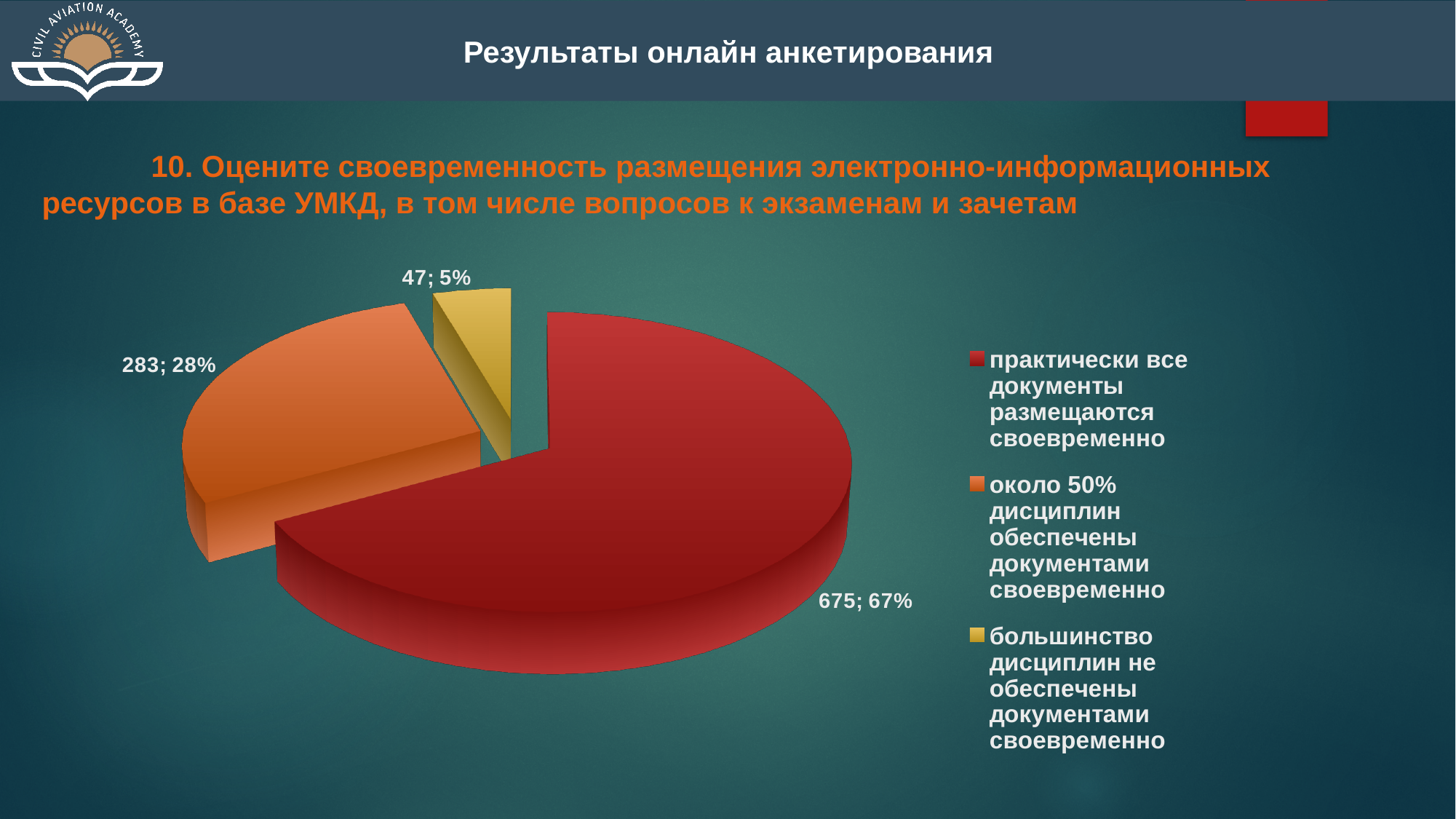
How many respondents chose "около 50% дисциплин обеспечены документами своевременно"? 283 What is the difference in respondents between "практически все документы размещаются своевременно" and "около 50% дисциплин обеспечены документами своевременно"? 392 What share of the pie does "практически все документы размещаются своевременно" take? 67% Which category has the largest slice? практически все документы размещаются своевременно How many entries does the legend list? 3 What share of the pie does "большинство дисциплин не обеспечены документами своевременно" take? 5% What colour is the slice for "около 50% дисциплин обеспечены документами своевременно"? orange Which category has the smallest slice? большинство дисциплин не обеспечены документами своевременно How many slices does the pie chart have? 3 How many respondents chose "практически все документы размещаются своевременно"? 675 How many respondents chose "большинство дисциплин не обеспечены документами своевременно"? 47 What kind of chart is shown on the slide? pie chart